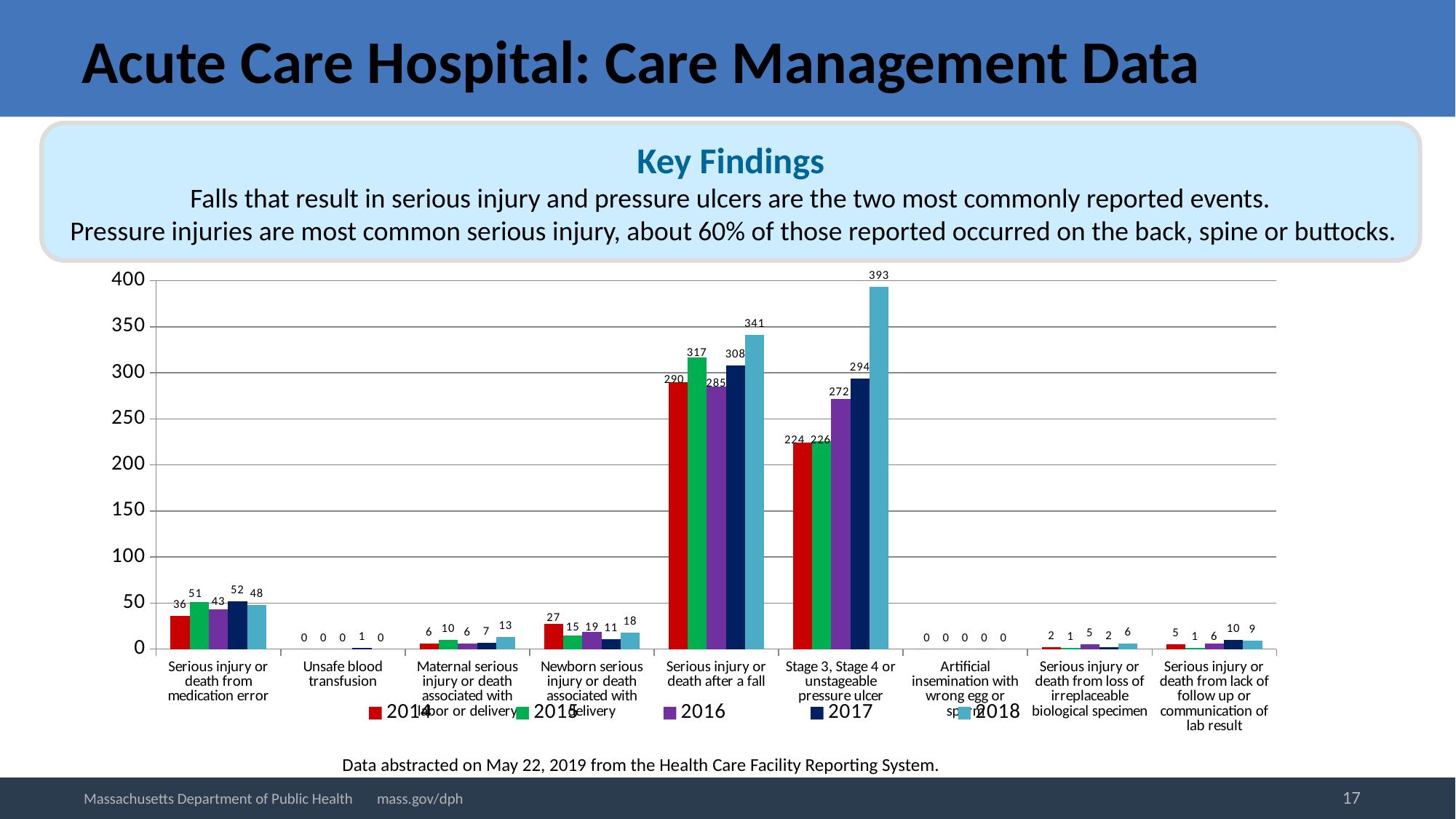
What is the 2018 value for Stage 3, Stage 4 or unstageable pressure ulcer? 393 What is the 2015 value for Serious injury or death after a fall? 317 What type of chart is shown on the slide? bar chart Which is larger: the 2018 value for Serious injury or death after a fall or the 2018 value for Stage 3, Stage 4 or unstageable pressure ulcer? Stage 3, Stage 4 or unstageable pressure ulcer How many series does the legend list? 5 What is the 2014 value for Newborn serious injury or death associated with delivery? 27 Which year has the lowest value for Serious injury or death after a fall? 2016 Is the 2017 value for Serious injury or death after a fall greater or less than 300? greater Do the values for Stage 3, Stage 4 or unstageable pressure ulcer rise or fall from 2014 to 2018? rise How many categories are shown on the x axis? 9 What is the difference between the 2018 and 2017 values for Stage 3, Stage 4 or unstageable pressure ulcer? 99 Which year has the highest value for Serious injury or death from medication error? 2017